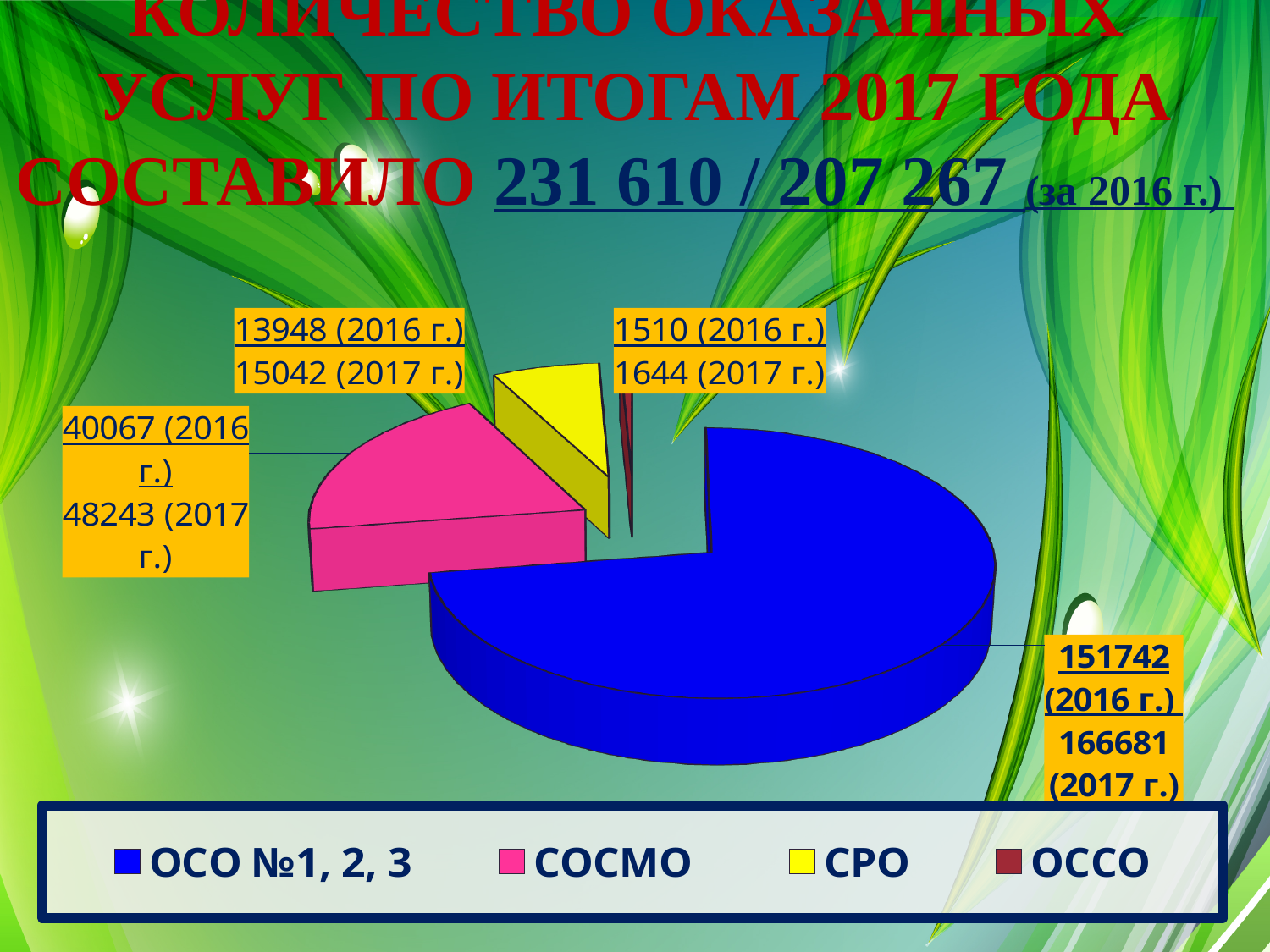
What is the difference between the 2017 and 2016 values for СОСМО? 8176 Which category has the smallest slice of the pie chart? ОССО What is the 2017 value for СРО on the pie chart? 15042 What type of chart is shown on the slide? Pie chart What is the 2016 value for ОССО on the pie chart? 1510 What is the 2017 value for ОСО №1, 2, 3 on the pie chart? 166681 What is the 2016 value for СОСМО on the pie chart? 40067 Which is larger: the 2017 value for СРО or the 2017 value for ОССО? СРО Which category has the largest slice of the pie chart? ОСО №1, 2, 3 How many categories does the pie chart show? 4 What colour is the СОСМО slice in the pie chart? Pink By how much did the value for ОСО №1, 2, 3 increase from 2016 to 2017? 14939